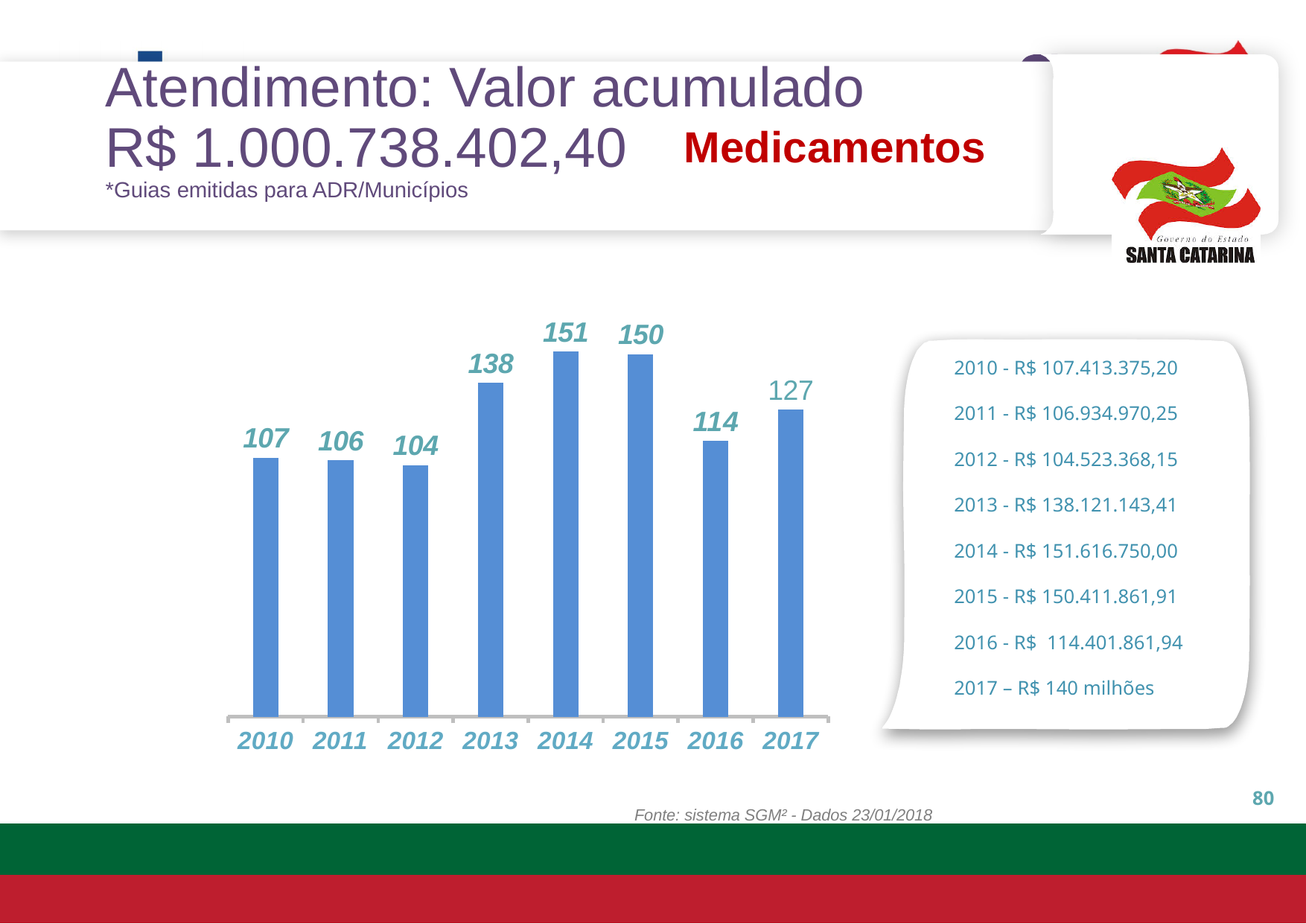
Which year has the lowest value? 2012 What kind of chart is shown on the slide? bar chart What is the difference between the values for 2014 and 2016? 37 Which is larger, the value for 2017 or the value for 2016? 2017 What is the value shown for 2017? 127 What is the difference between the values for 2013 and 2012? 34 How many years are shown on the x axis? 8 Do the values rise or fall from 2012 to 2014? rise What is the value shown for 2013? 138 What is the value shown for 2016? 114 Which year has the highest value? 2014 Which is larger, the value for 2010 or the value for 2012? 2010